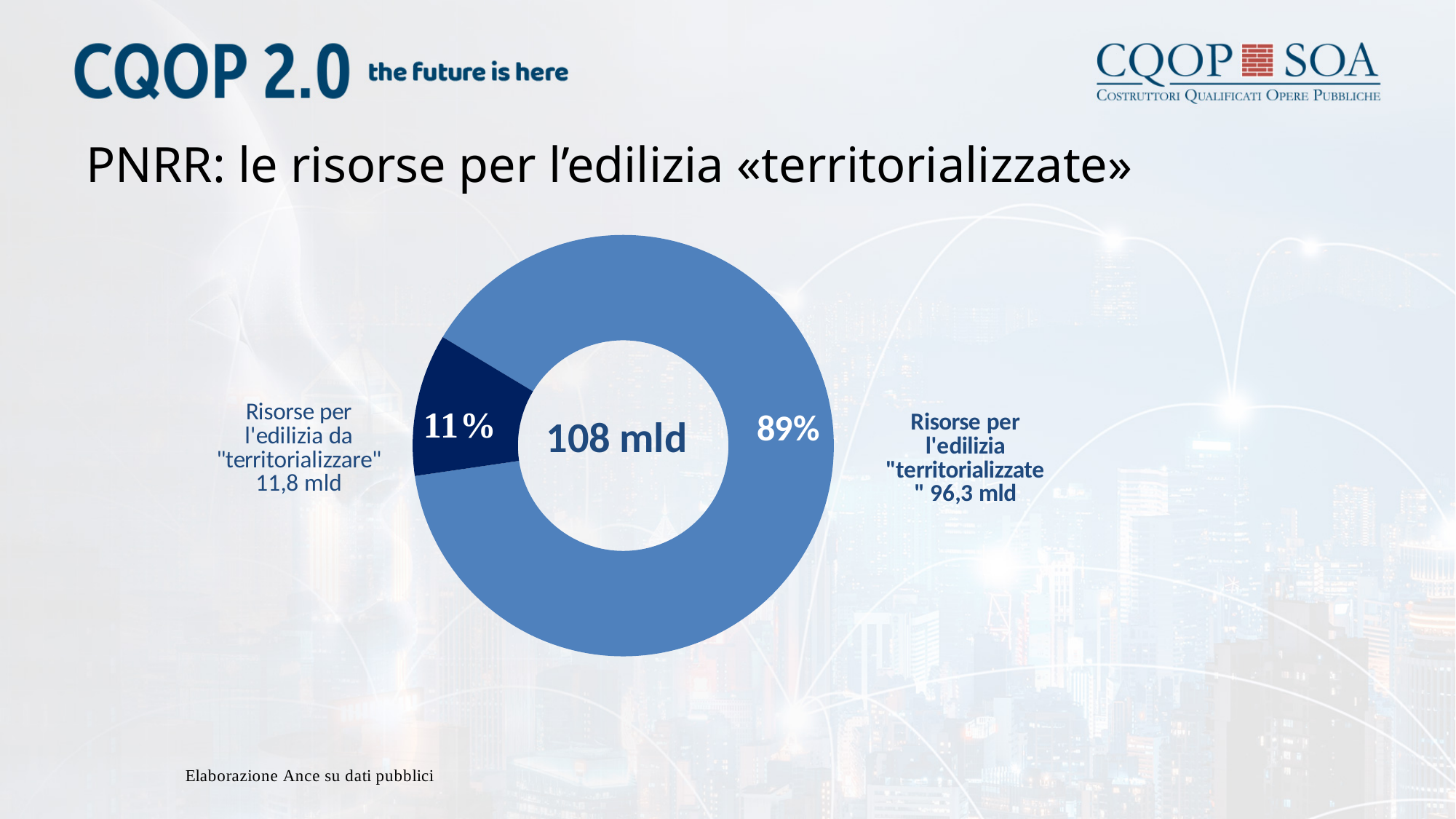
What is the difference in percentage points between the 89% slice and the 11% slice? 78 percentage points What value in mld is given for 'Risorse per l'edilizia "territorializzate"'? 96,3 mld What kind of chart is shown on the slide? Doughnut (pie) chart What total is shown in the centre of the doughnut chart? 108 mld What share of the chart is labelled for 'Risorse per l'edilizia "territorializzate"'? 89% Which is larger: the share for 'territorializzate' or the share for 'da territorializzare'? territorializzate What is the title of the slide above the chart? PNRR: le risorse per l'edilizia «territorializzate» What share of the chart is labelled for 'Risorse per l'edilizia da "territorializzare"'? 11% How many slices does the chart have? 2 What value in mld is given for 'Risorse per l'edilizia da "territorializzare"'? 11,8 mld Which slice is the largest? Risorse per l'edilizia "territorializzate" Which slice is the smallest? Risorse per l'edilizia da "territorializzare"